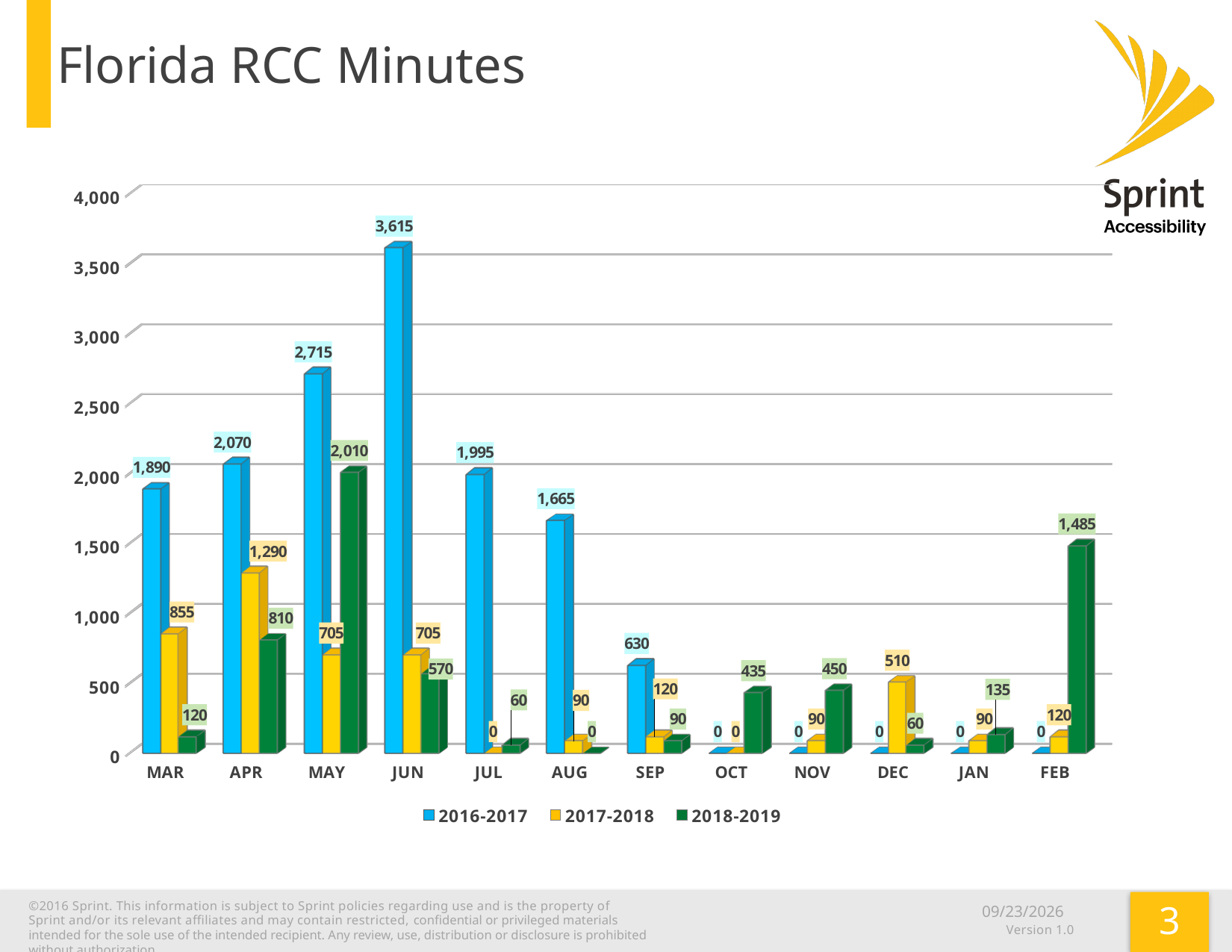
How many series does the legend list? 3 What is the 2018-2019 value for FEB? 1,485 Is the 2016-2017 value for MAY greater or less than 2,500? greater Which month has the highest 2018-2019 value? MAY What is the 2016-2017 value for JUN? 3,615 What type of chart is shown on the slide? bar chart Which is larger for DEC, the 2017-2018 value or the 2018-2019 value? 2017-2018 How many months are shown on the x axis? 12 What is the 2017-2018 value for APR? 1,290 Which month has the highest 2016-2017 value? JUN What is the title of the chart? Florida RCC Minutes What is the difference between the 2016-2017 and 2017-2018 values for MAR? 1,035